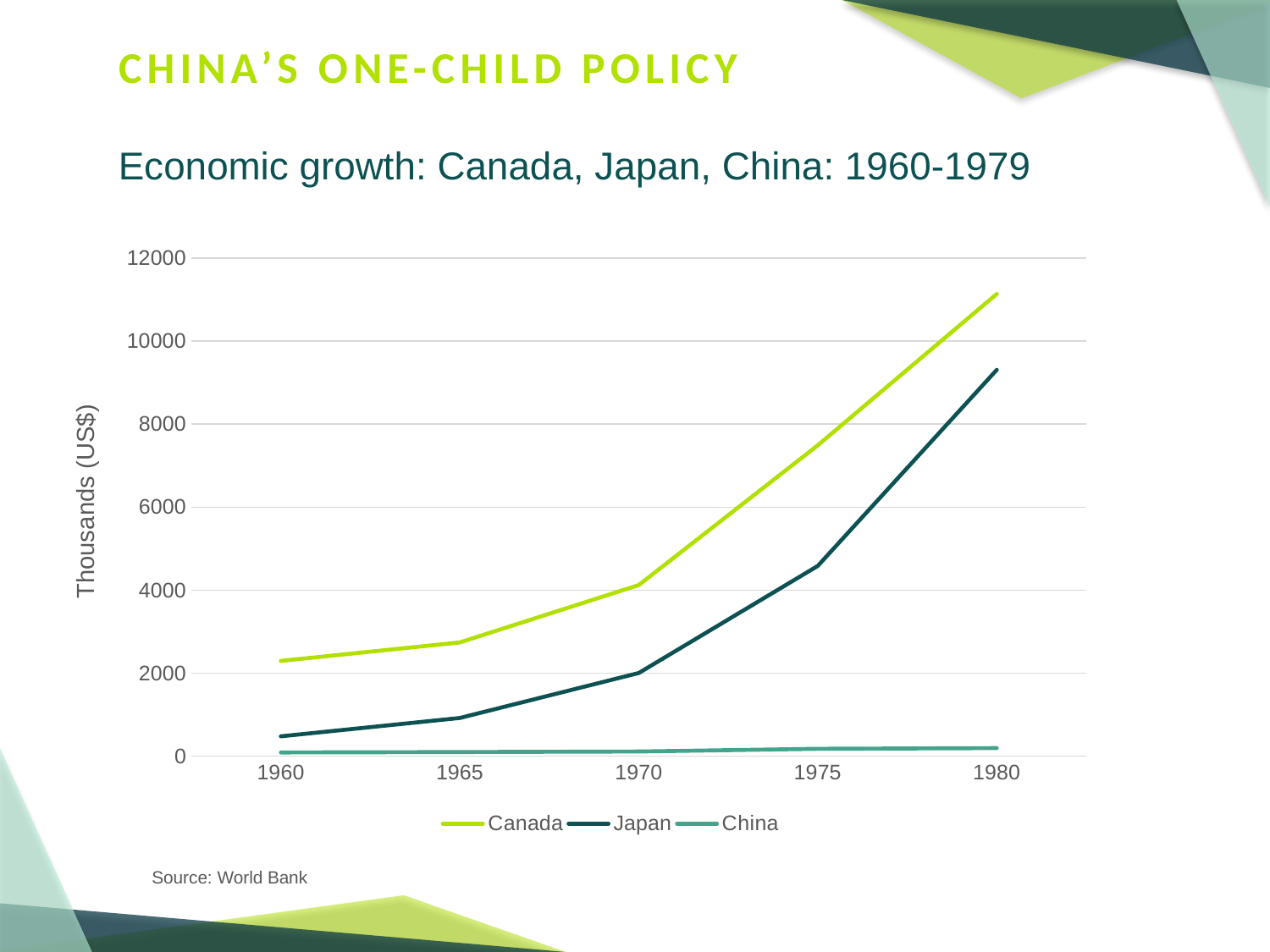
Is the value for Canada in 1960 greater or less than 2000? greater Is the value for Canada in 1980 greater or less than 10000? greater Which series has the lowest value in 1980? China Is the value for Japan in 1975 greater or less than 4000? greater What kind of chart is shown on the slide? line chart Which series has the highest value in 1980? Canada Which is larger in 1970, the value for Canada or the value for Japan? Canada How many years are marked on the x axis? 5 How many series does the legend list? 3 Does the Japan line rise or fall from 1960 to 1980? rise